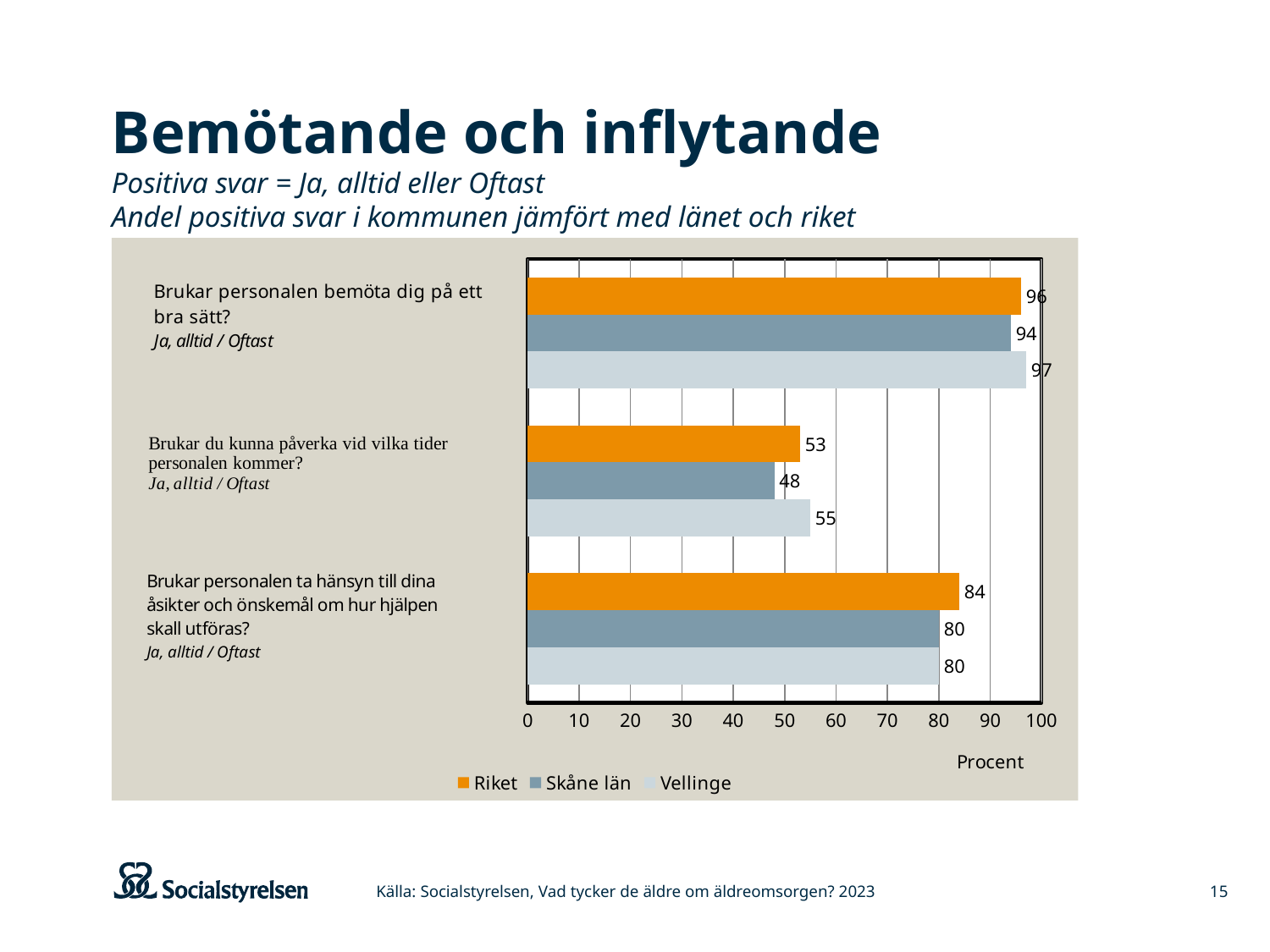
How many series does the legend list? 3 What is the difference between the Vellinge and Skåne län values on the question "Brukar du kunna påverka vid vilka tider personalen kommer?"? 7 What is the value for Vellinge on the question "Brukar personalen ta hänsyn till dina åsikter och önskemål om hur hjälpen skall utföras?"? 80 What is the value for Skåne län on the question "Brukar du kunna påverka vid vilka tider personalen kommer?"? 48 Is the value for Riket on the question "Brukar du kunna påverka vid vilka tider personalen kommer?" greater or less than 50? greater What is the difference between the Riket and Skåne län values on the question "Brukar personalen ta hänsyn till dina åsikter och önskemål om hur hjälpen skall utföras?"? 4 Which series has the highest value on the question "Brukar du kunna påverka vid vilka tider personalen kommer?"? Vellinge Which series has the lowest value on the question "Brukar personalen bemöta dig på ett bra sätt?"? Skåne län Which is larger on the question "Brukar personalen bemöta dig på ett bra sätt?": the value for Riket or the value for Vellinge? Vellinge What is the value for Riket on the question "Brukar personalen bemöta dig på ett bra sätt?"? 96 What kind of chart is shown on the slide? Bar chart How many questions (categories) are shown in the chart? 3